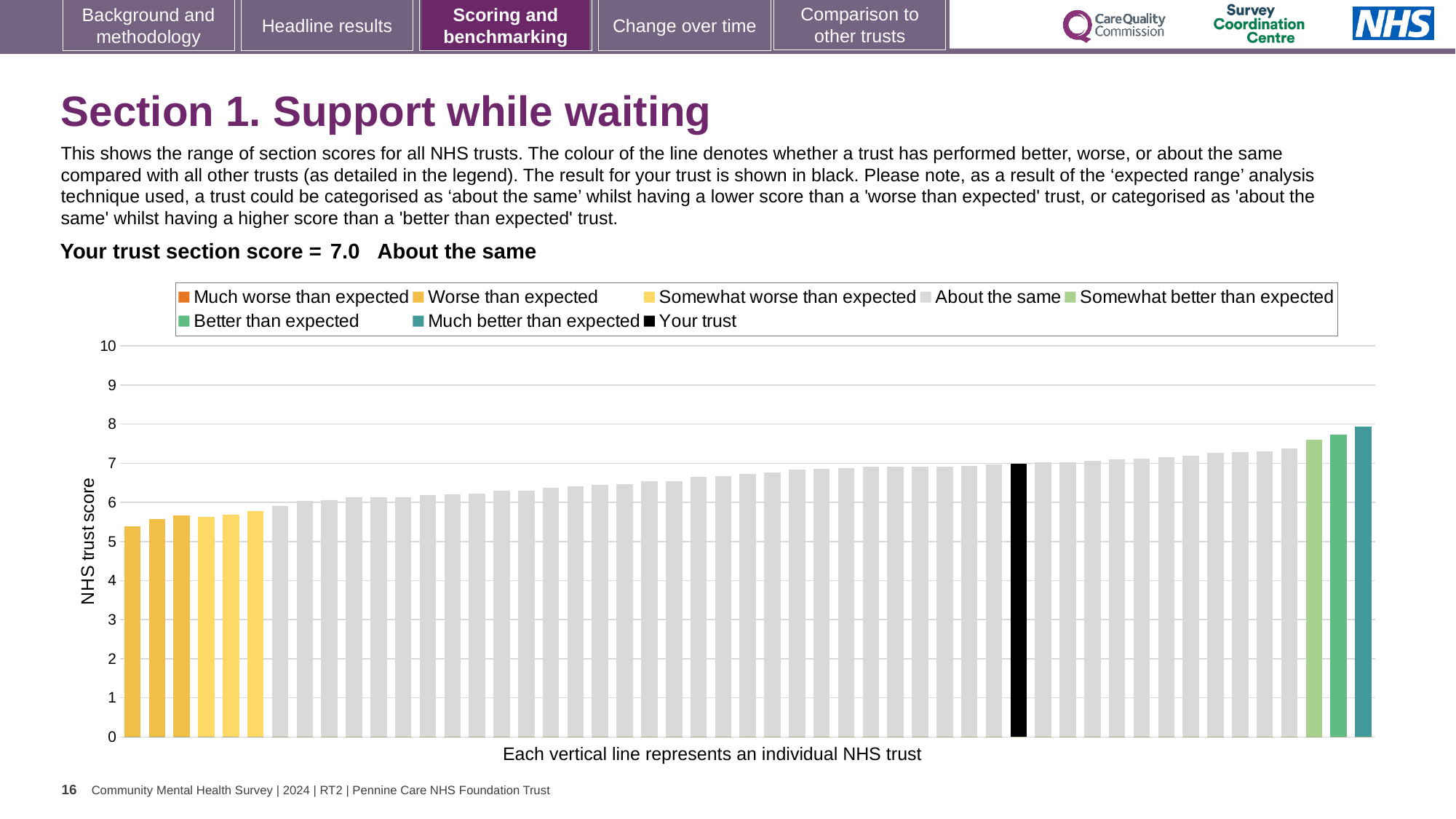
Is the value of the highest bar in the chart greater or less than 7? greater Is the value for your trust (the black bar) greater or less than 5? greater How many bars are coloured as 'Better than expected' (green)? 1 Which legend category does the tallest bar in the chart belong to? Much better than expected What is the section score for your trust shown on the slide? 7.0 What is the label on the y axis of the chart? NHS trust score Is the value of the lowest bar in the chart greater or less than 6? less Do the bar values rise or fall from left to right along the x axis? rise How many entries does the chart legend list? 8 Which legend category does the shortest bar in the chart belong to? Worse than expected What kind of chart is shown on the slide? bar chart Which benchmarking category is your trust placed in for this section? About the same